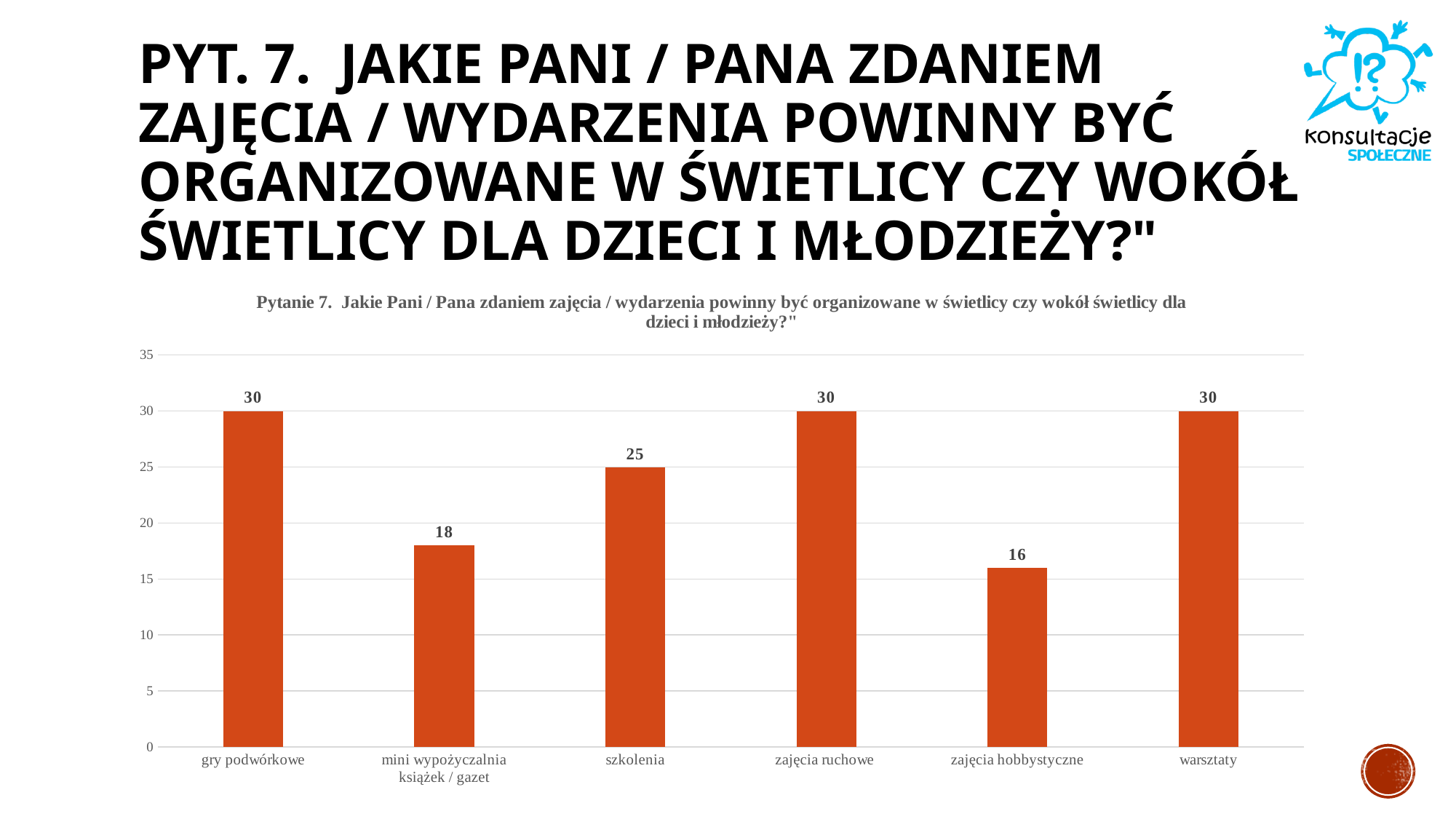
Which category has the lowest value? zajęcia hobbystyczne What is the value for mini wypożyczalnia książek / gazet? 18 Which is larger, the value for szkolenia or the value for mini wypożyczalnia książek / gazet? szkolenia How many categories share the highest value of 30? 3 Is the value for zajęcia ruchowe greater or less than 25? greater What is the value for warsztaty? 30 What is the value for szkolenia? 25 What is the value for zajęcia hobbystyczne? 16 What kind of chart is shown on the slide? bar chart What is the difference between the values for gry podwórkowe and mini wypożyczalnia książek / gazet? 12 How many categories are shown on the x axis? 6 What is the difference between the values for szkolenia and zajęcia hobbystyczne? 9